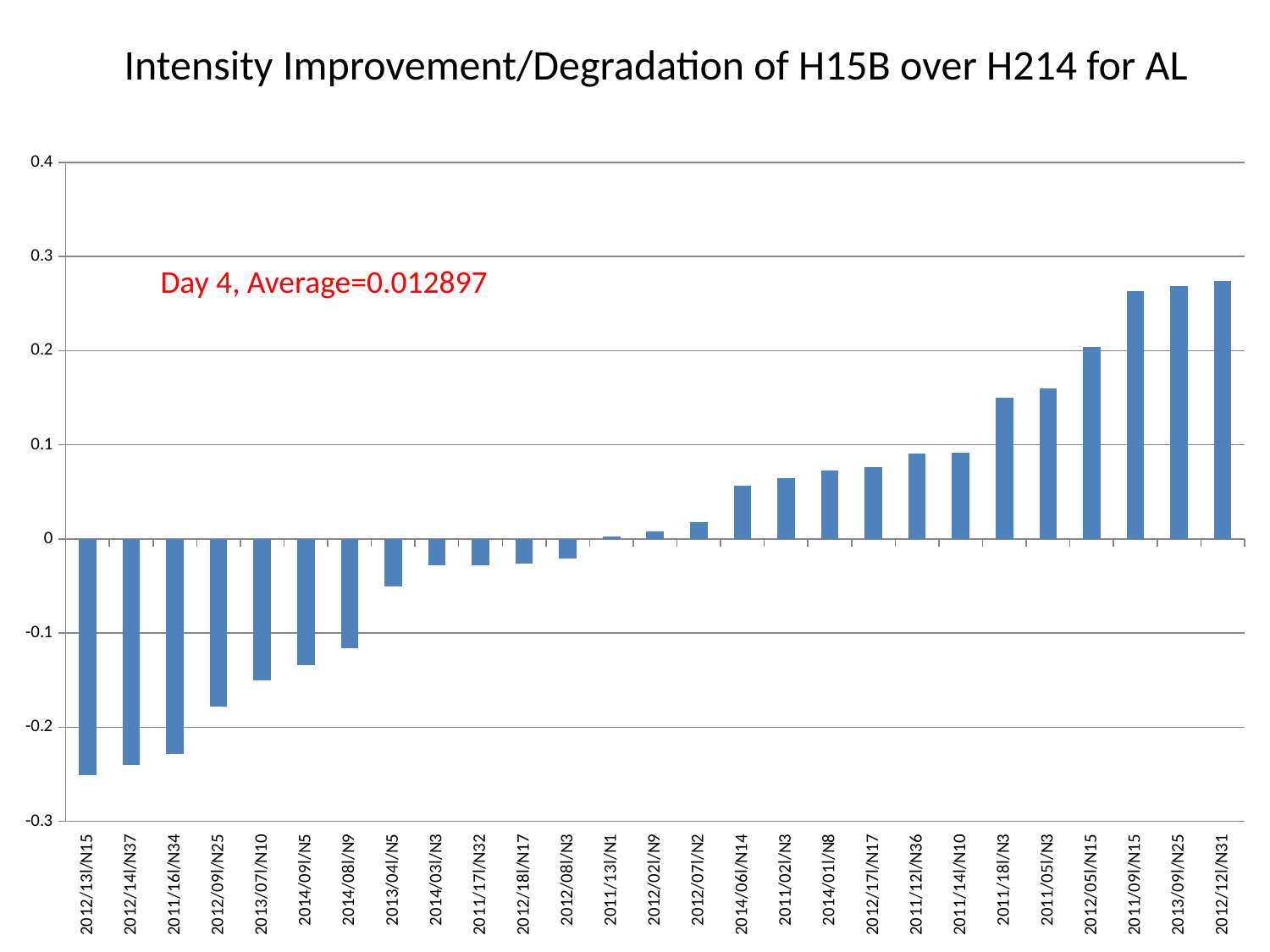
Is the value for 2012/13l/N15 greater or less than -0.2? less Which has the larger value, 2012/13l/N15 or 2012/12l/N31? 2012/12l/N31 Is the value for 2012/12l/N31 greater or less than 0.2? greater Is the value for 2014/06l/N14 greater or less than 0.1? less How many categories (bars) are plotted on the chart? 27 What average value is stated in the annotation on the chart? 0.012897 What is the title of the chart? Intensity Improvement/Degradation of H15B over H214 for AL How many bars on the chart have negative values? 12 What kind of chart is shown on the slide? bar chart Do the bar values rise or fall moving from left to right along the x axis? rise Which has the larger value, 2011/16l/N34 or 2012/09l/N25? 2012/09l/N25